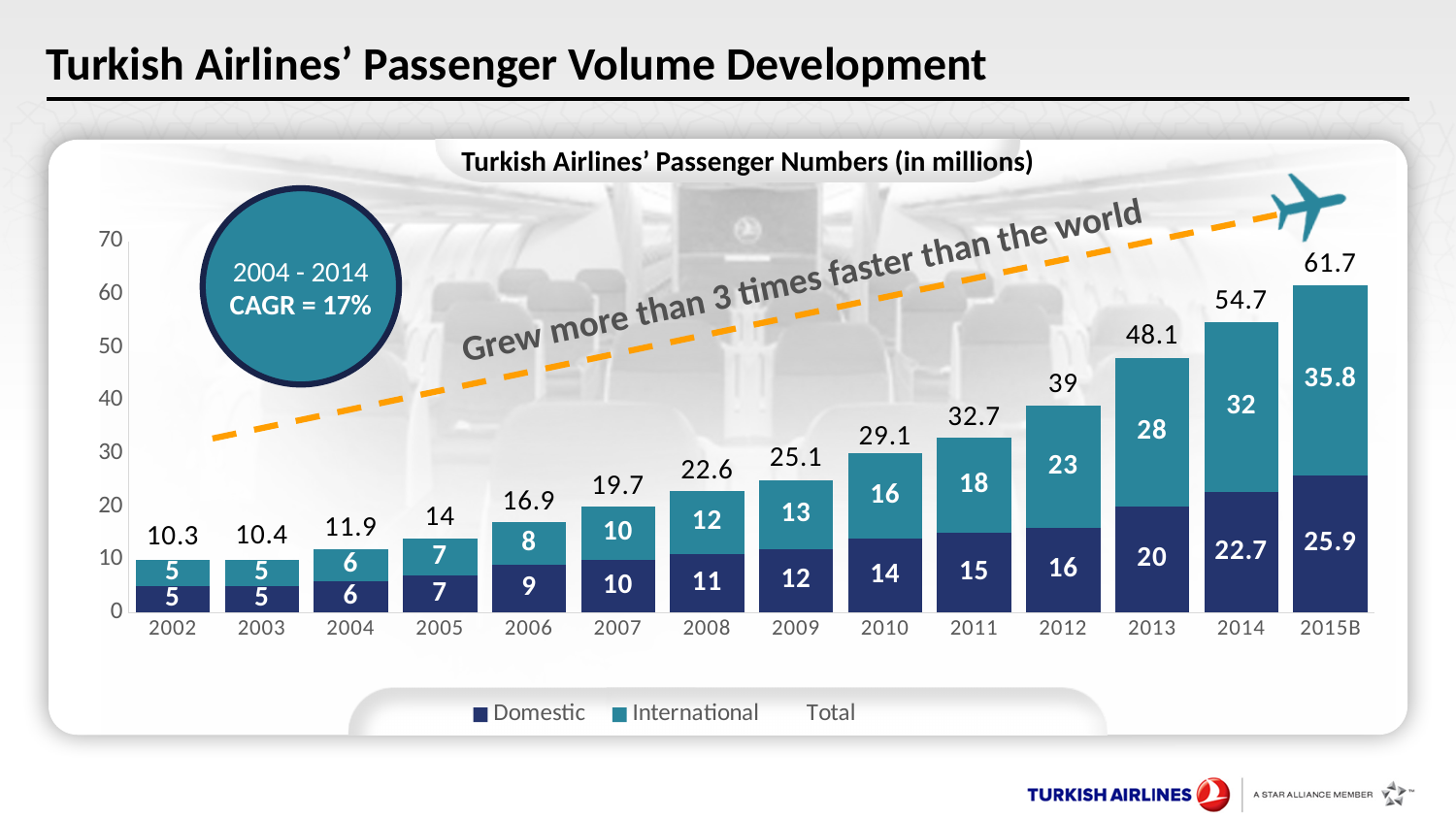
What is the International passenger value for 2012? 23 Do the total passenger numbers rise or fall from 2002 to 2015B? Rise What CAGR is stated in the circle for 2004 - 2014? 17% What is the difference between the total passenger numbers for 2013 and 2012? 9.1 What is the total passenger number shown for 2014? 54.7 Which year has the lowest total passenger number? 2002 How many entries does the legend list? 3 What kind of chart is shown on the slide? Stacked bar chart How many years are shown on the x axis? 14 Which is larger in 2011, the Domestic value or the International value? International Which year has the highest total passenger number? 2015B What is the Domestic passenger value for 2015B? 25.9